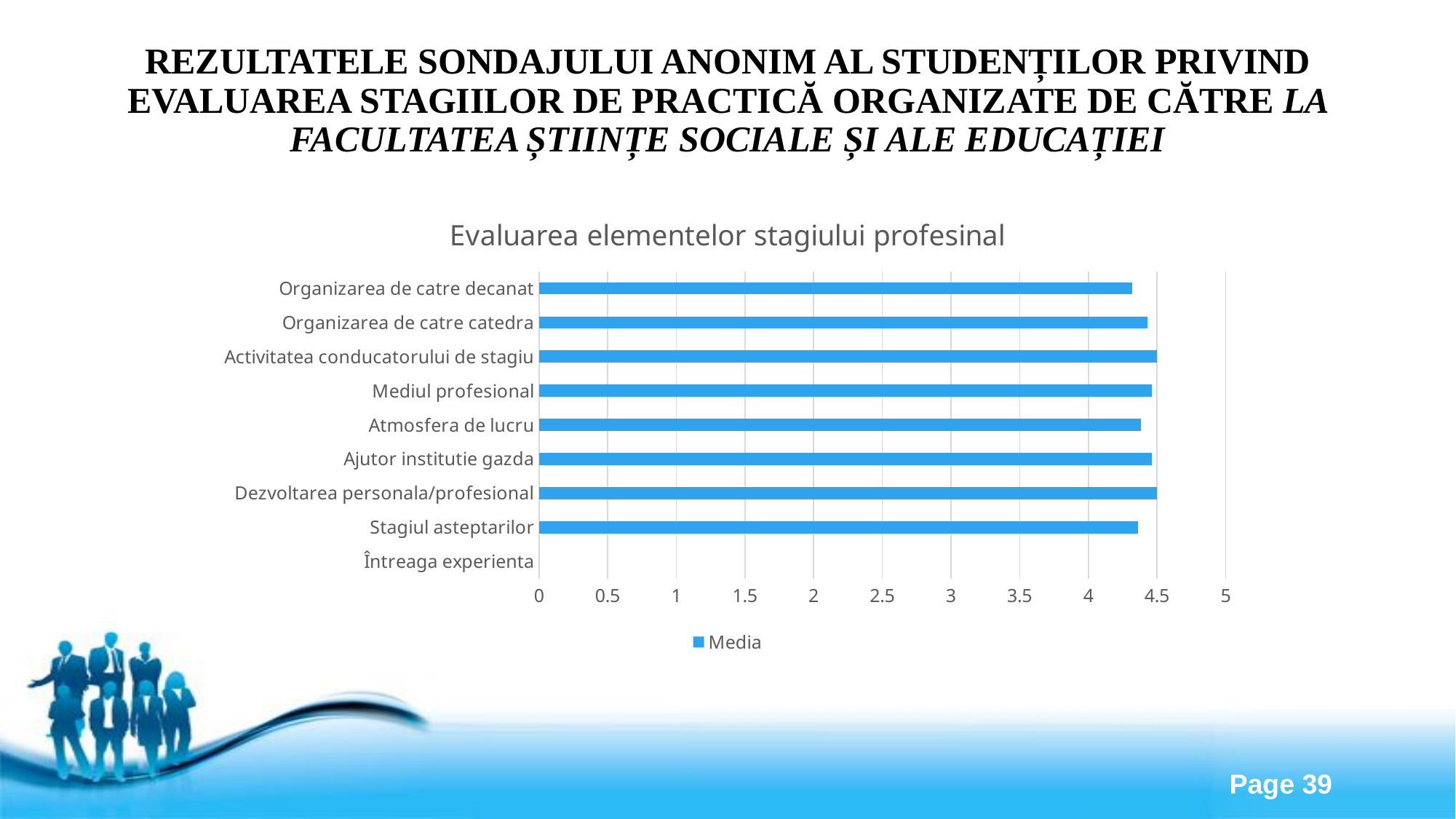
What is the name of the series shown in the legend? Media How many categories are listed on the vertical axis of the chart? 9 How many series does the chart legend list? 1 Is the value for Stagiul asteptarilor greater or less than 4? greater What is the title of the chart? Evaluarea elementelor stagiului profesinal Is the value for Organizarea de catre decanat greater or less than 4? greater What kind of chart is shown on the slide? Bar chart Which is larger: the value for Organizarea de catre decanat or the value for Activitatea conducatorului de stagiu? Activitatea conducatorului de stagiu Which is larger: the value for Dezvoltarea personala/profesional or the value for Organizarea de catre decanat? Dezvoltarea personala/profesional Is the value for Atmosfera de lucru greater or less than 3.5? greater Which category has the lowest value in the chart? Întreaga experienta